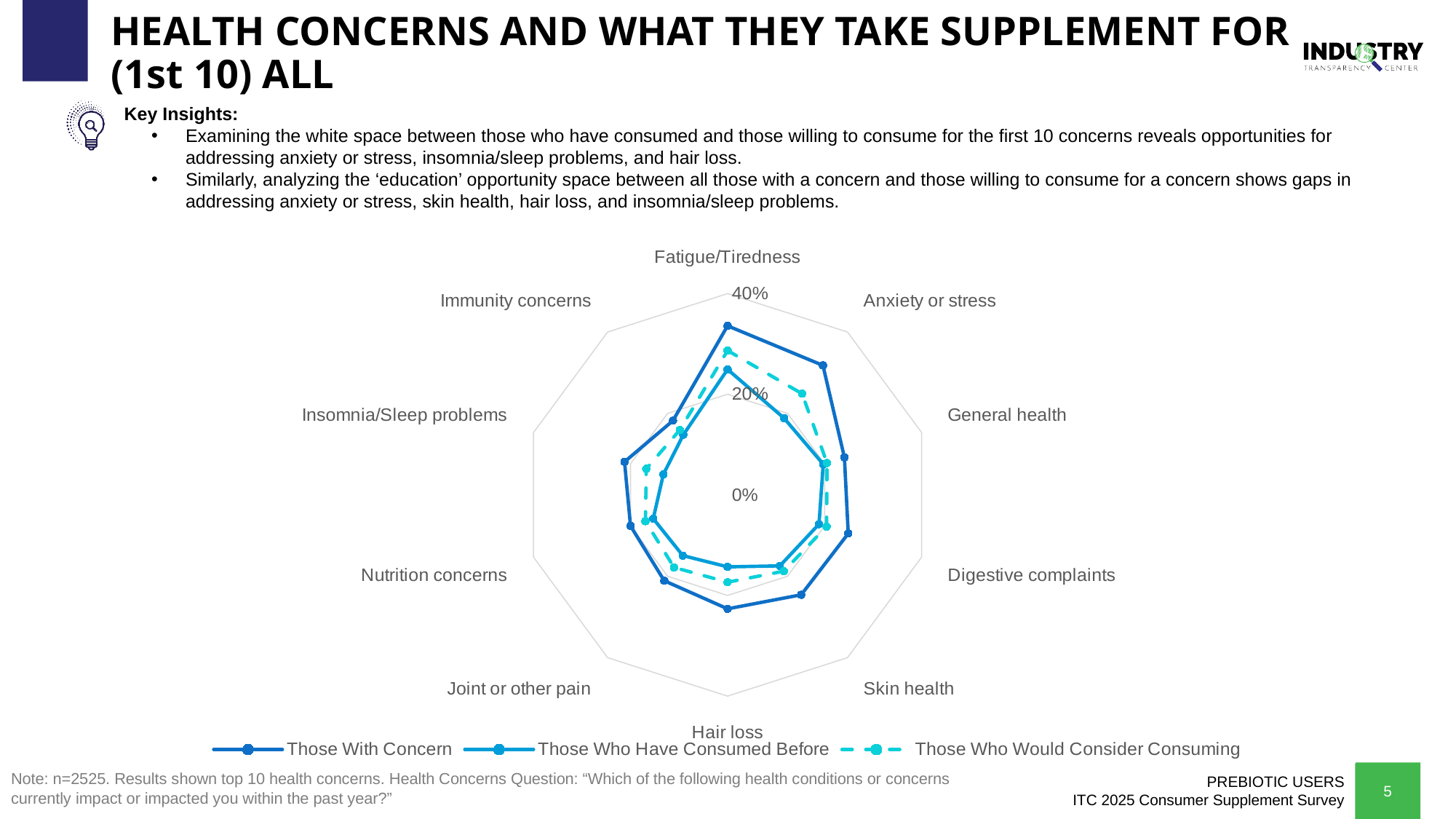
Which series is drawn with a dashed line in the chart? Those Who Would Consider Consuming Is the value for Immunity concerns in the Those Who Have Consumed Before series greater or less than 20%? less What are the three series listed in the chart legend? Those With Concern, Those Who Have Consumed Before, Those Who Would Consider Consuming Is the value for Nutrition concerns in the Those Who Have Consumed Before series greater or less than 20%? less In the Those With Concern series, which has the larger value: Fatigue/Tiredness or Hair loss? Fatigue/Tiredness Is the value for Fatigue/Tiredness in the Those Who Would Consider Consuming series greater or less than 20%? greater How many series does the chart legend list? 3 For Fatigue/Tiredness, which series has the larger value: Those With Concern or Those Who Have Consumed Before? Those With Concern How many health concern categories are plotted on the radar chart? 10 What kind of chart is shown on the slide? Radar chart